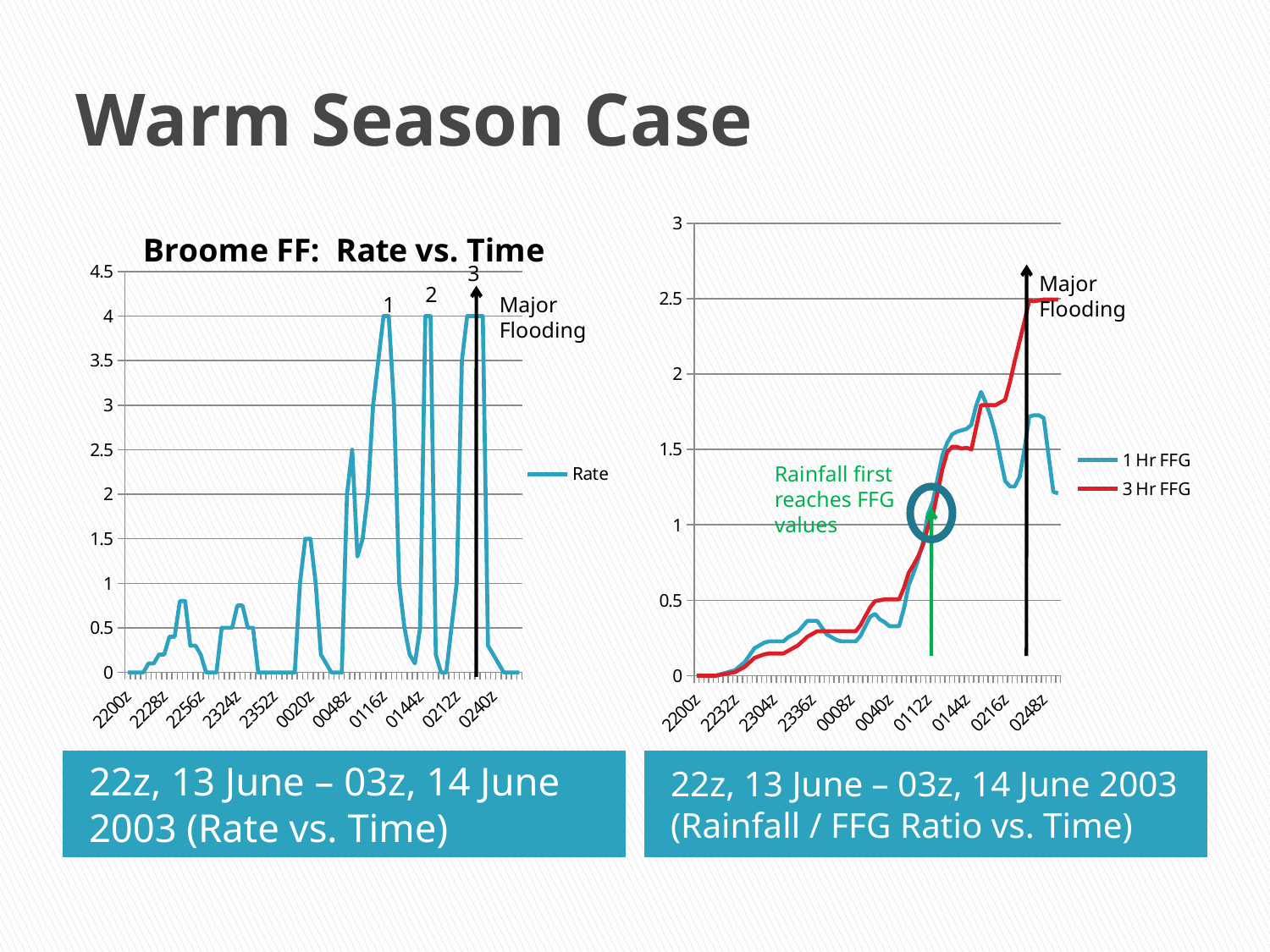
In the left chart 'Broome FF: Rate vs. Time', what is the highest value reached by the Rate series? 4 What type of chart is the left chart titled 'Broome FF: Rate vs. Time'? line chart In the right chart (Rainfall / FFG Ratio vs. Time), which series is higher at 0248z, 1 Hr FFG or 3 Hr FFG? 3 Hr FFG In the right chart (Rainfall / FFG Ratio vs. Time), do the 1 Hr FFG and 3 Hr FFG values generally rise or fall from 2200z to 0216z? rise How many series does the legend of the left chart 'Broome FF: Rate vs. Time' list? 1 In the right chart (Rainfall / FFG Ratio vs. Time), is the value of 3 Hr FFG at 0216z greater or less than 1.5? greater How many series does the legend of the right chart (Rainfall / FFG Ratio vs. Time) list? 2 What is the name of the series plotted in the left chart 'Broome FF: Rate vs. Time'? Rate In the left chart 'Broome FF: Rate vs. Time', what is the value of Rate at 2200z? 0 What type of chart is the right chart (Rainfall / FFG Ratio vs. Time)? line chart In the left chart 'Broome FF: Rate vs. Time', how many peaks are numbered with labels? 3 In the right chart (Rainfall / FFG Ratio vs. Time), is the value of 1 Hr FFG at 0248z greater or less than 1.5? greater